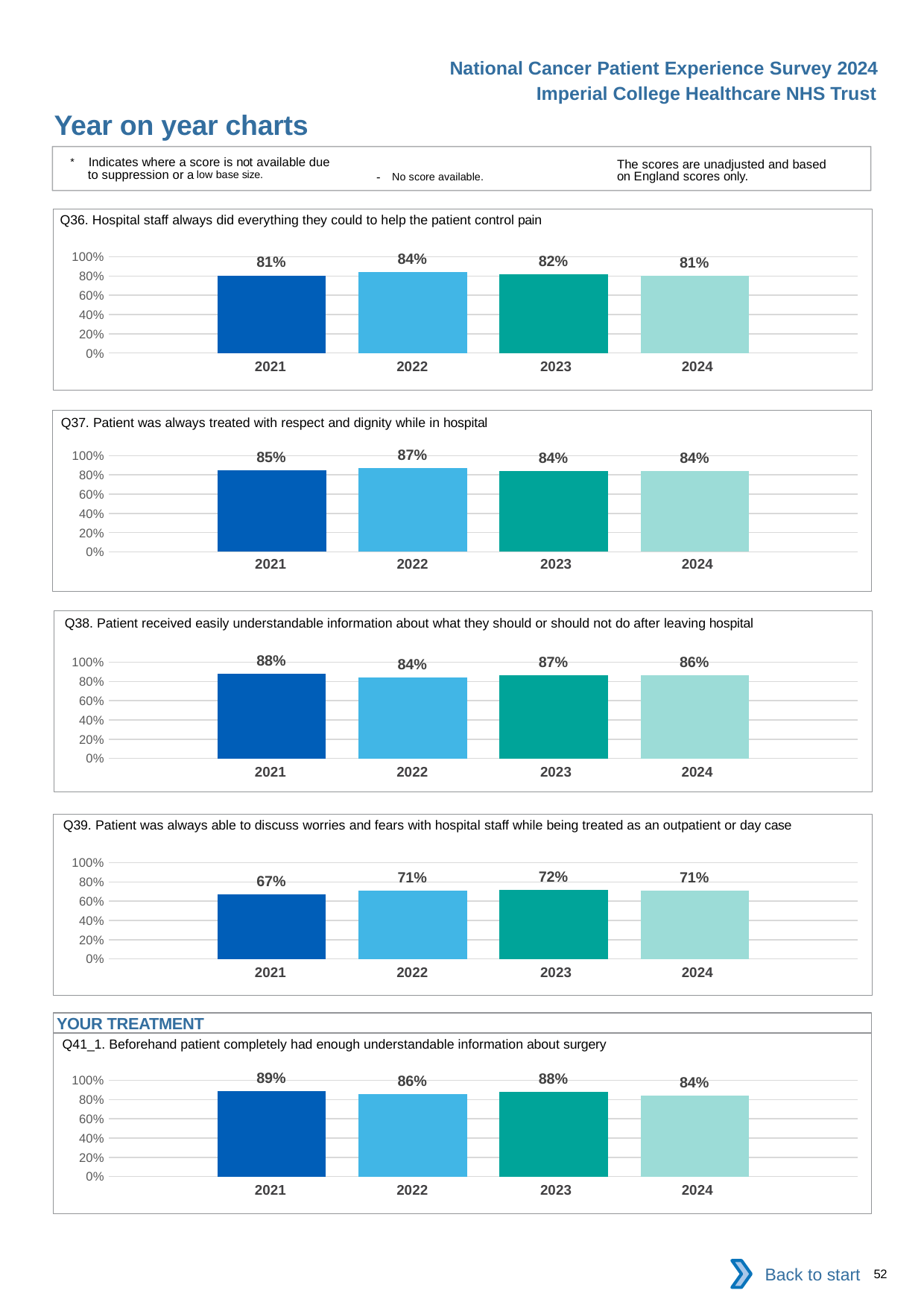
In the Q41_1 chart (beforehand patient completely had enough understandable information about surgery), which is larger: the value for 2021 or the value for 2024? 2021 In the Q39 chart (patient was always able to discuss worries and fears with hospital staff while being treated as an outpatient or day case), what is the difference between the 2023 and 2021 values? 5 percentage points How many charts are shown on the slide? 5 In the Q37 chart (patient was always treated with respect and dignity while in hospital), which year has the highest value? 2022 In the Q36 chart (hospital staff always did everything they could to help the patient control pain), what is the value for 2022? 84% In the Q36 chart (hospital staff always did everything they could to help the patient control pain), what is the value for 2024? 81% In the Q39 chart (patient was always able to discuss worries and fears with hospital staff), is the value for 2021 greater or less than 80%? less In the Q38 chart (patient received easily understandable information about what they should or should not do after leaving hospital), which year has the lowest value? 2022 In the Q41_1 chart (beforehand patient completely had enough understandable information about surgery), what is the value for 2024? 84% What kind of chart is the Q37 chart (patient was always treated with respect and dignity while in hospital)? Bar chart How many years are plotted in the Q36 chart (hospital staff always did everything they could to help the patient control pain)? 4 In the Q38 chart (patient received easily understandable information about what they should or should not do after leaving hospital), what is the difference between the 2021 and 2024 values? 2 percentage points